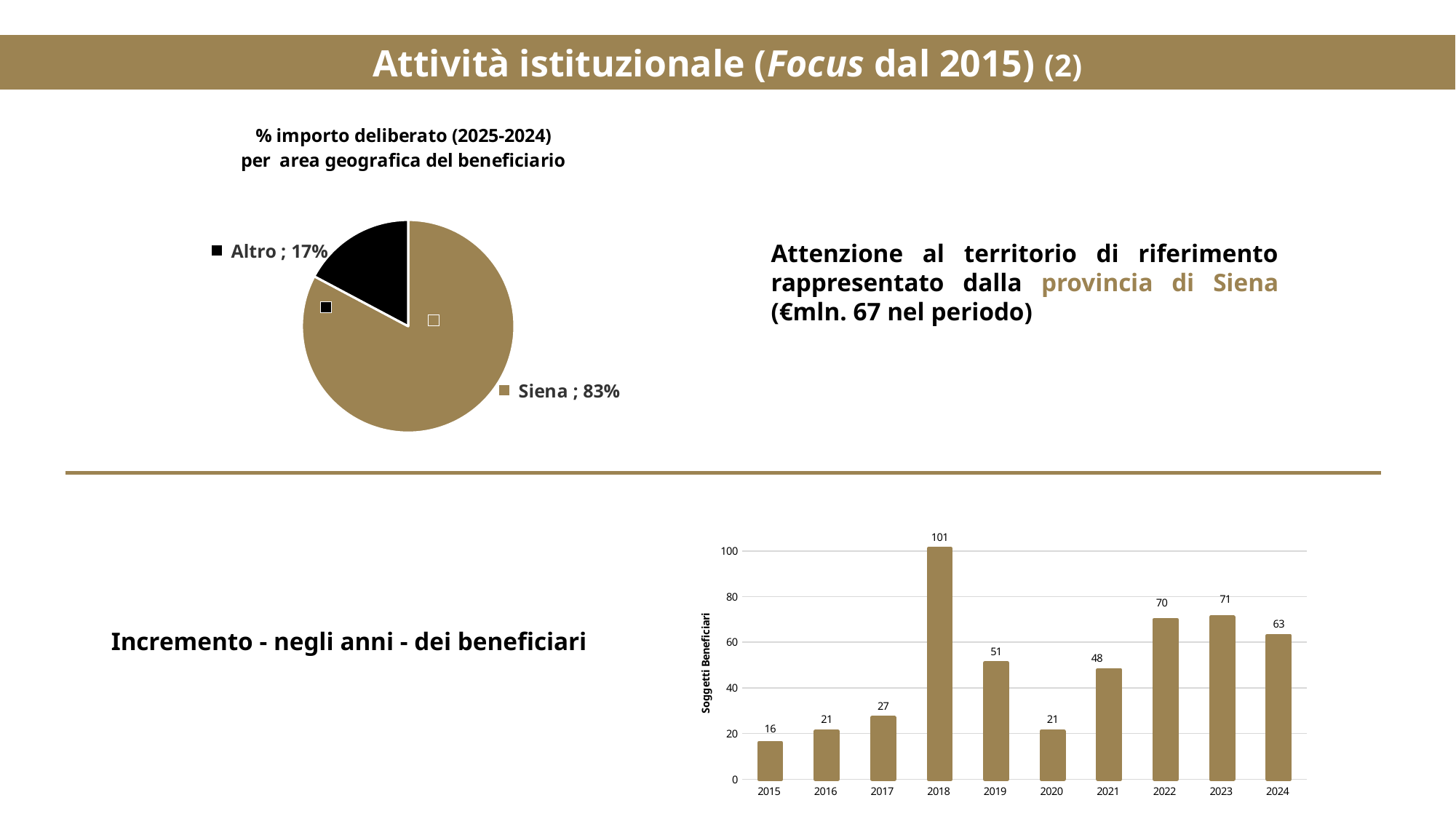
What kind of chart is the chart at the top left of the slide? pie chart In the pie chart '% importo deliberato (2025-2024) per area geografica del beneficiario', what share does Siena have? 83% In the pie chart '% importo deliberato (2025-2024) per area geografica del beneficiario', what share does Altro have? 17% What is the y-axis label of the bar chart at the bottom right? Soggetti Beneficiari In the bar chart at the bottom right, which year has the lowest value? 2015 In the bar chart at the bottom right, how many years are shown on the x axis? 10 In the pie chart at the top left, how many slices are there? 2 In the bar chart at the bottom right, what is the value for 2018? 101 In the bar chart at the bottom right, which year has the highest value? 2018 In the bar chart at the bottom right, what is the difference between the values for 2023 and 2022? 1 In the bar chart at the bottom right, which is larger, the value for 2019 or the value for 2021? 2019 In the bar chart at the bottom right, what is the value for 2015? 16